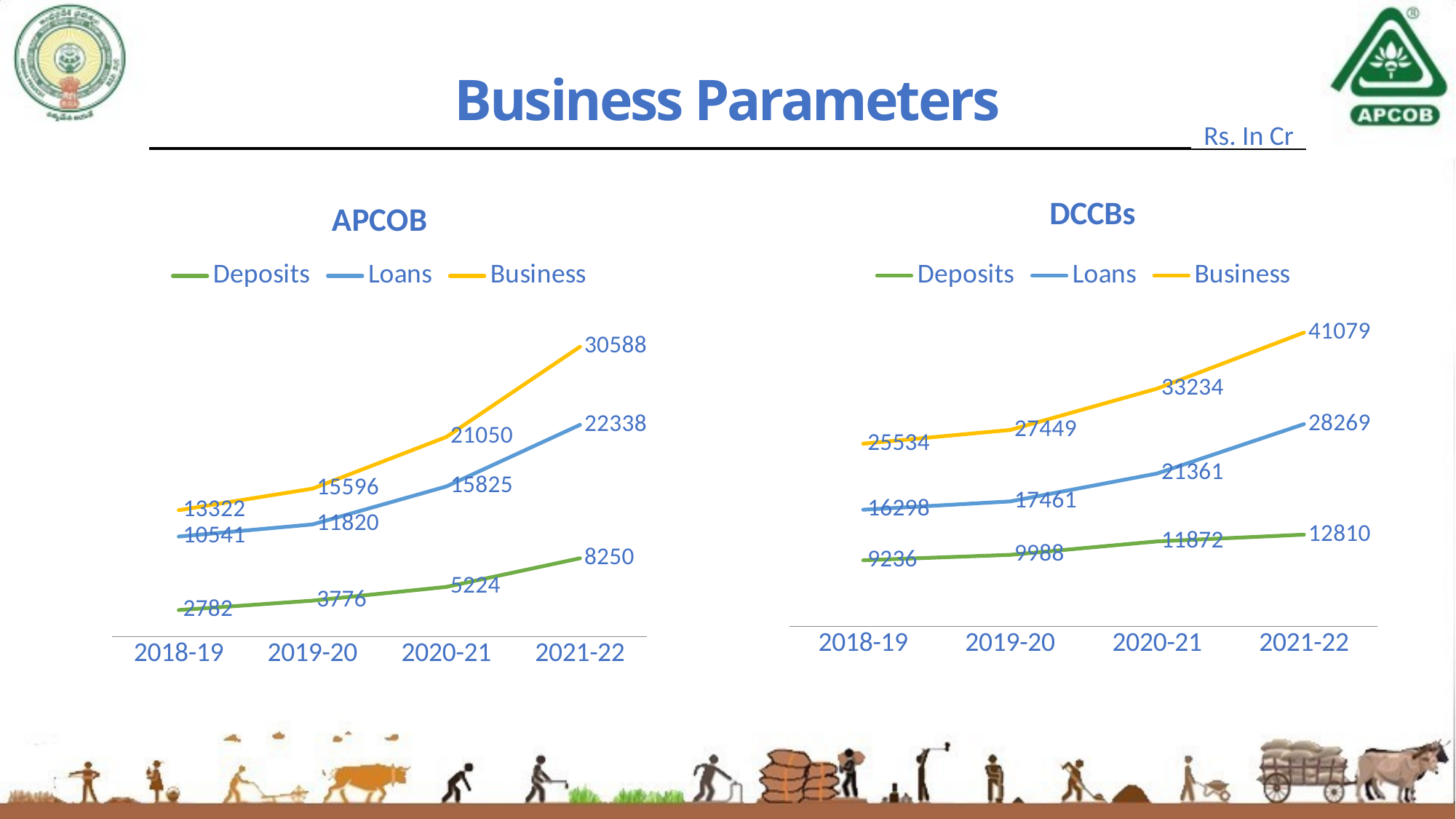
In the APCOB chart, what is the Business value for 2021-22? 30588 In the APCOB chart, which year has the highest Deposits value? 2021-22 Which is larger: the 2021-22 Business value in the APCOB chart or the 2021-22 Business value in the DCCBs chart? DCCBs In the DCCBs chart, what is the Deposits value for 2018-19? 9236 In the DCCBs chart, what is the Loans value for 2020-21? 21361 In the DCCBs chart, what is the difference between the Loans values for 2021-22 and 2018-19? 11971 In the APCOB chart, what is the difference between the Business values for 2021-22 and 2020-21? 9538 How many years are shown on the x axis of the APCOB chart? 4 In the DCCBs chart, which year has the lowest Business value? 2018-19 What kind of chart is the APCOB chart? line chart How many series does the legend of the DCCBs chart list? 3 In the APCOB chart, what is the Loans value for 2019-20? 11820